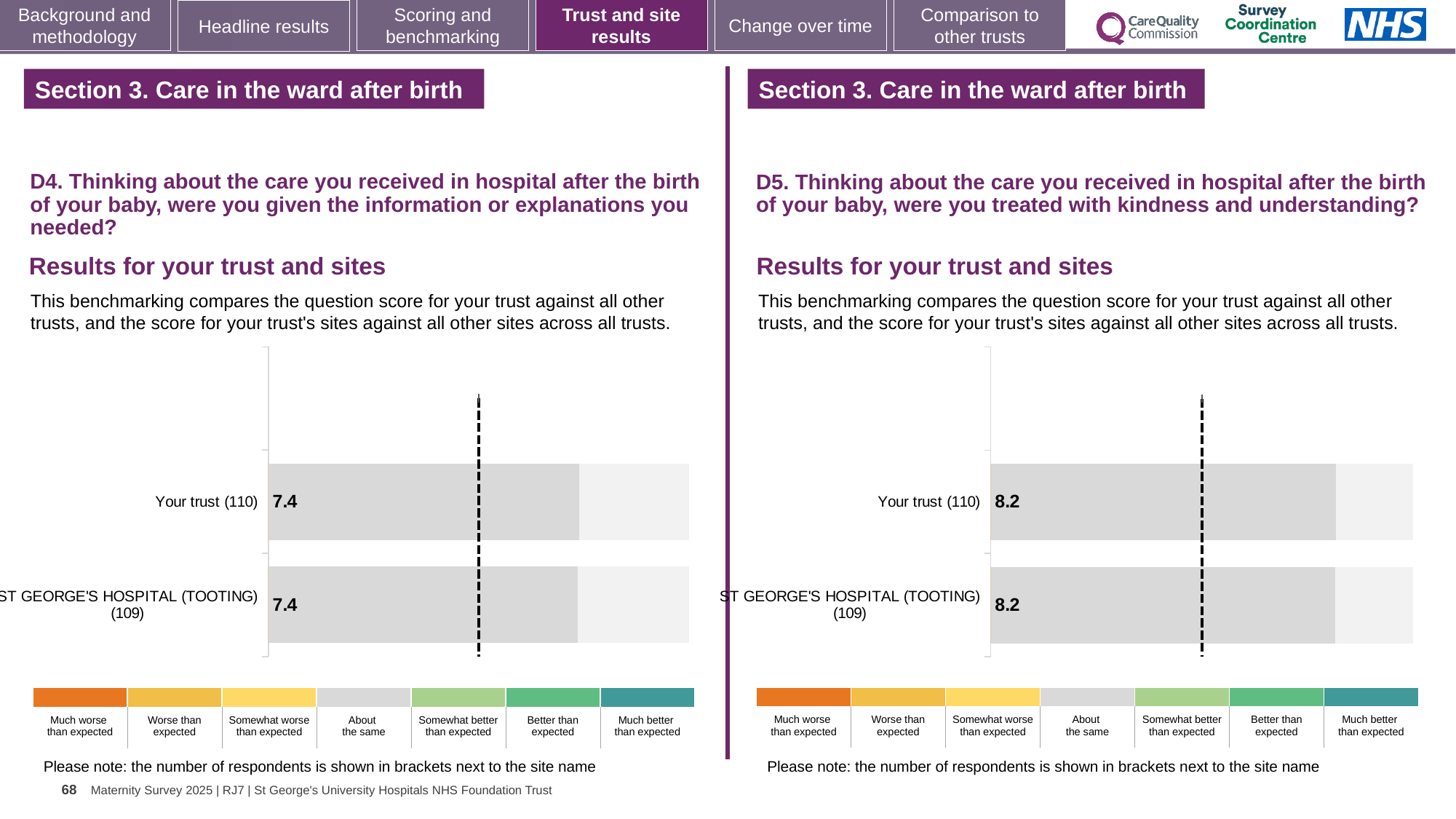
In the right chart (D5), what is the score for Your trust (110)? 8.2 How many categories does the colour key below the left chart (D4) list? 7 In the colour key below the right chart (D5), what colour represents 'About the same'? Grey How many bars are plotted in the left chart (D4)? 2 In the right chart (D5), what is the difference between the score for Your trust and the score for ST GEORGE'S HOSPITAL (TOOTING)? 0.0 In the right chart (D5), what is the score for ST GEORGE'S HOSPITAL (TOOTING) (109)? 8.2 What kind of chart is used in the left chart (D4)? Bar chart How many bars are plotted in the right chart (D5)? 2 In the left chart (D4), what is the score for ST GEORGE'S HOSPITAL (TOOTING) (109)? 7.4 In the left chart (D4), what is the score for Your trust (110)? 7.4 How many respondents are shown in brackets for Your trust in the right chart (D5)? 110 In the left chart (D4), what is the difference between the score for Your trust and the score for ST GEORGE'S HOSPITAL (TOOTING)? 0.0